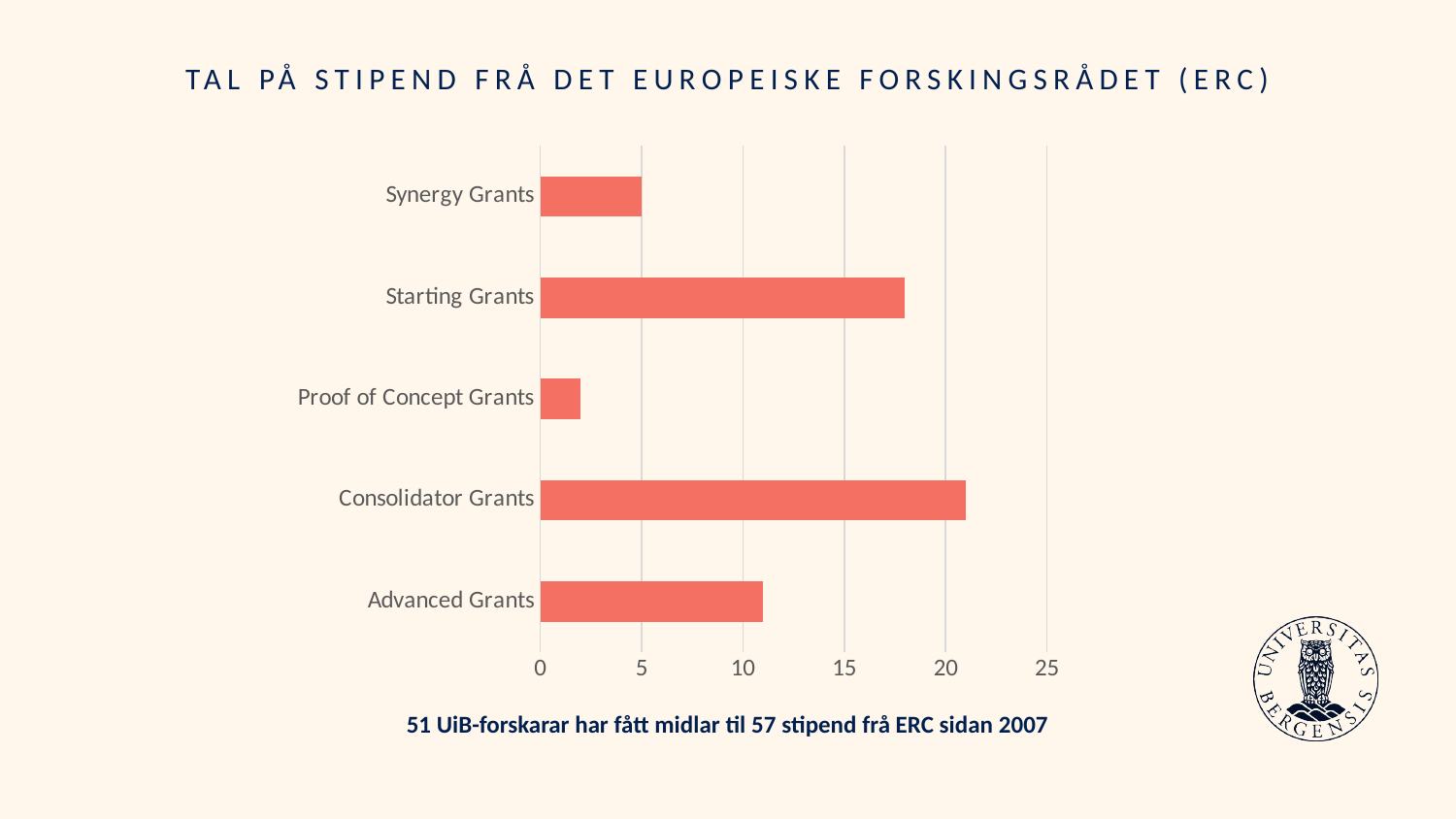
Is the value for Starting Grants greater or less than 15? greater Is the value for Advanced Grants greater or less than 15? less Is the value for Proof of Concept Grants greater or less than 5? less Which grant category has the lowest value? Proof of Concept Grants How many grant categories are shown in the chart? 5 What kind of chart is shown on the slide? bar chart Which grant category has the highest value? Consolidator Grants What is the title of the chart? Tal på stipend frå Det europeiske forskingsrådet (ERC) Which is larger, the value for Starting Grants or the value for Advanced Grants? Starting Grants What is the value for Synergy Grants? 5 According to the text below the chart, how many UiB researchers have received ERC funding since 2007? 51